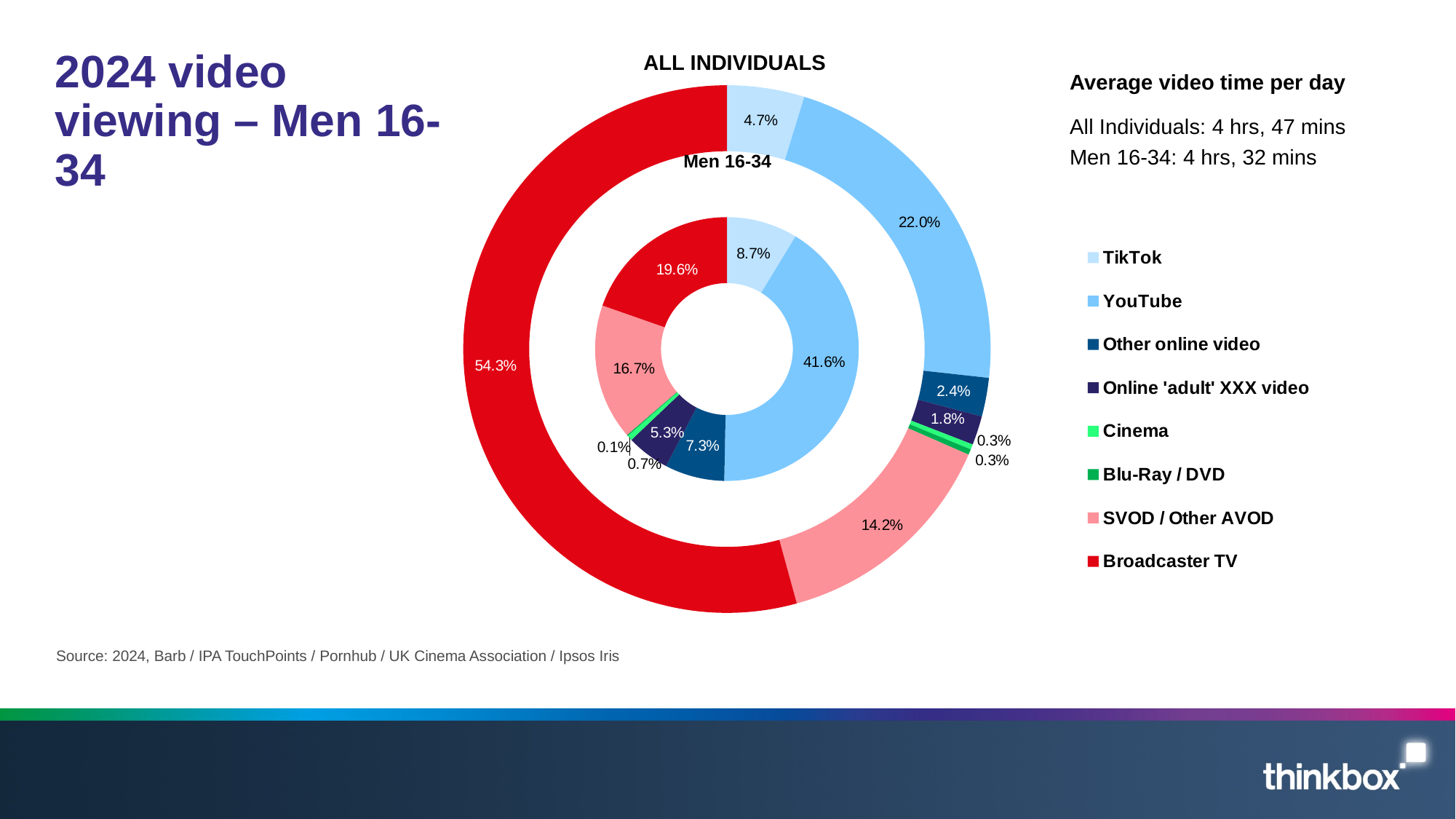
Which is larger for Men 16-34: the share for Other online video or the share for Online 'adult' XXX video? Other online video According to the slide, what is the average video time per day for Men 16-34? 4 hrs, 32 mins Which category has the largest share in the Men 16-34 ring? YouTube What is the difference between the Broadcaster TV share for ALL INDIVIDUALS and for Men 16-34? 34.7% In the ALL INDIVIDUALS ring, what share is Broadcaster TV? 54.3% How many categories does the legend list? 8 In the ALL INDIVIDUALS ring, what share is SVOD / Other AVOD? 14.2% What type of chart is shown on the slide? Doughnut chart In the Men 16-34 ring, what share is TikTok? 8.7% In the Men 16-34 ring, what share is YouTube? 41.6% Which category has the largest share in the ALL INDIVIDUALS ring? Broadcaster TV What is the difference between the YouTube share for Men 16-34 and for ALL INDIVIDUALS? 19.6%